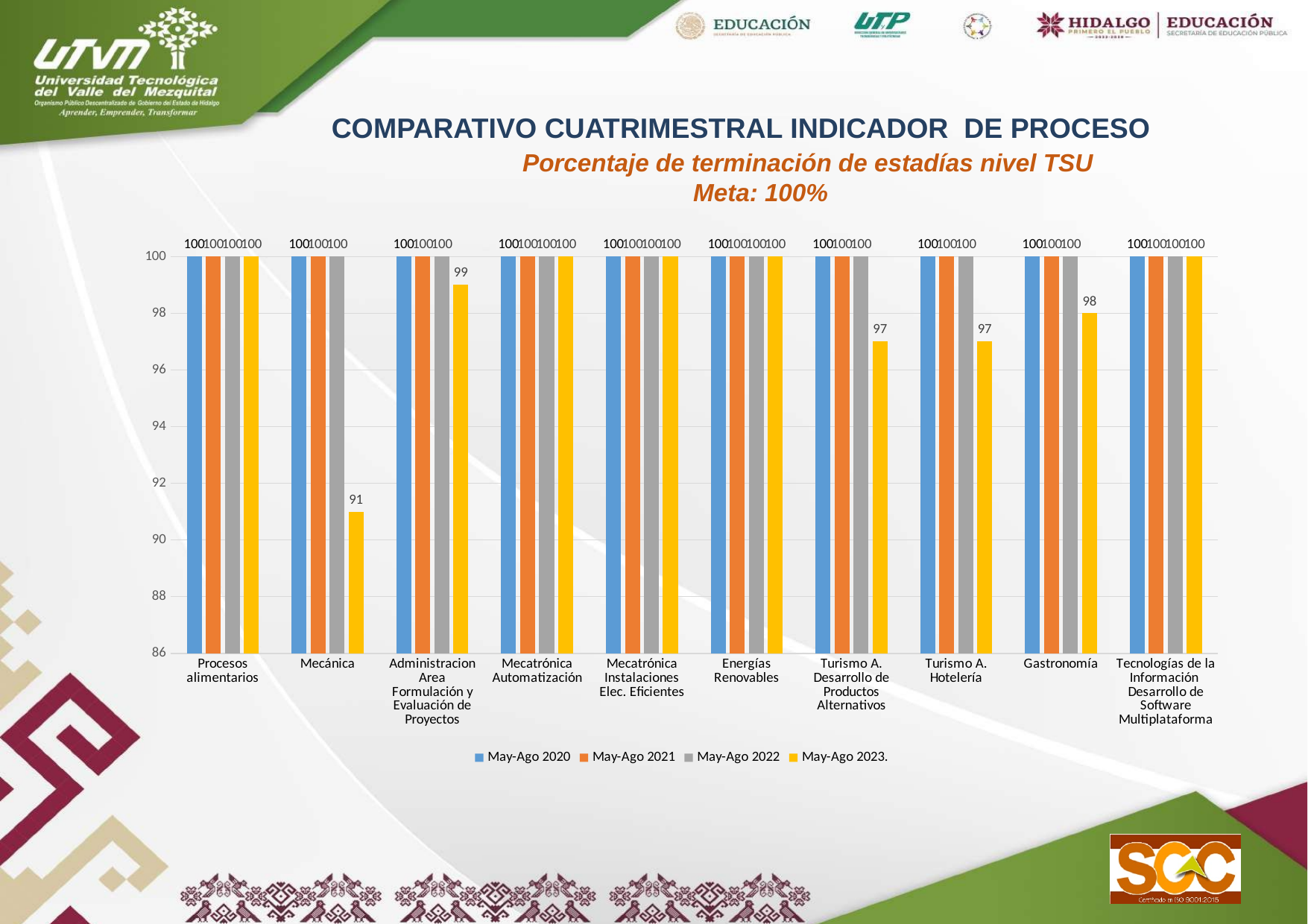
What kind of chart is shown on the slide? bar chart What is the value for Mecánica in May-Ago 2023? 91 What is the target (Meta) stated in the chart subtitle? 100% Which is larger for Turismo A. Desarrollo de Productos Alternativos: the May-Ago 2021 value or the May-Ago 2023 value? May-Ago 2021 What is the value for Gastronomía in May-Ago 2023? 98 How many series does the legend list? 4 How many categories (programs) are shown on the x axis? 10 What is the difference between the May-Ago 2022 and May-Ago 2023 values for Mecánica? 9 Is the May-Ago 2023 value for Turismo A. Hotelería greater or less than 98? less Which category has the lowest value in the May-Ago 2023 series? Mecánica What is the value for Administracion Area Formulación y Evaluación de Proyectos in May-Ago 2023? 99 What is the value for Turismo A. Hotelería in May-Ago 2022? 100